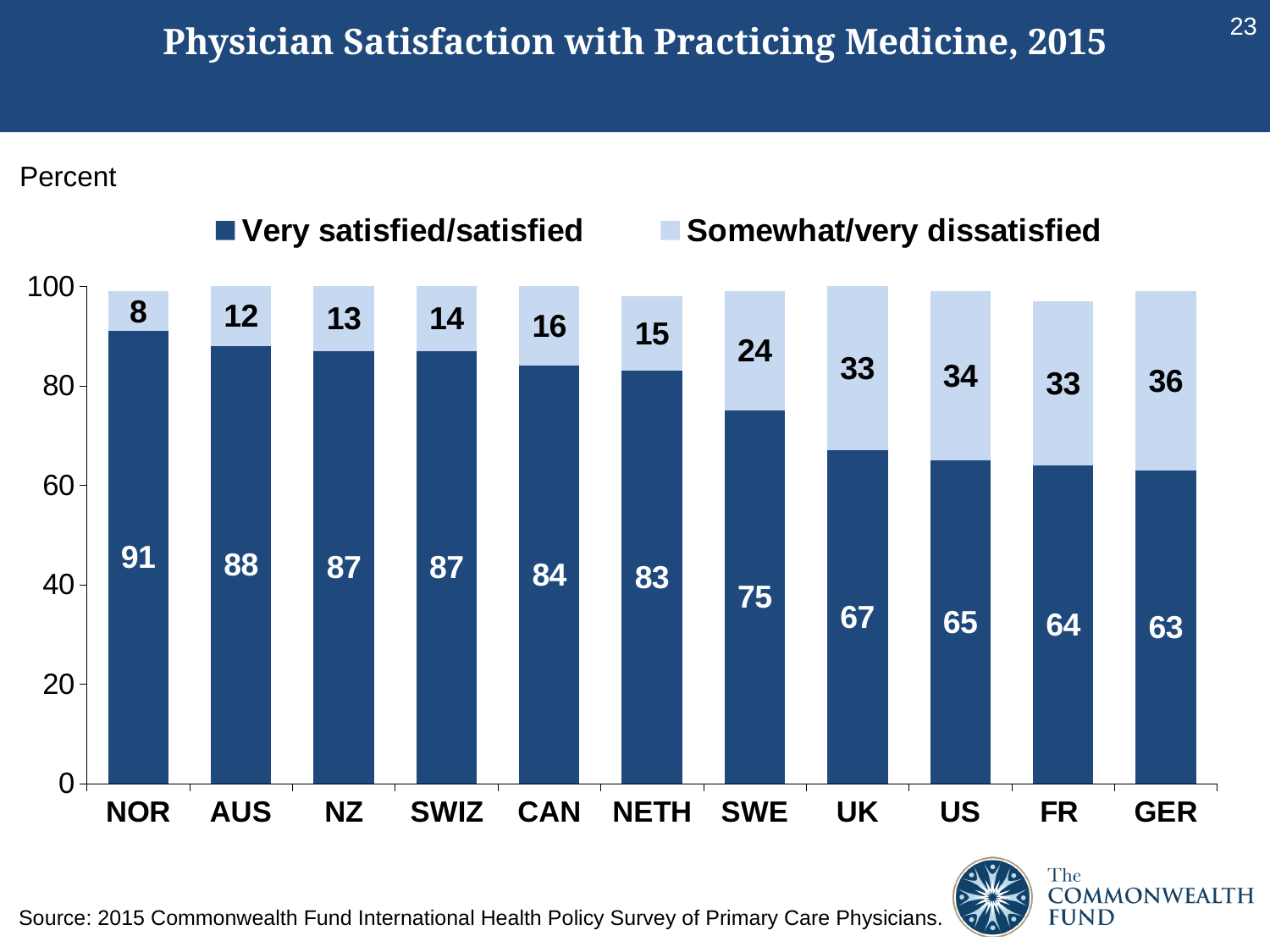
What kind of chart is shown on the slide? Stacked bar chart Which is larger, the Somewhat/very dissatisfied value for SWE or for UK? UK What is the Somewhat/very dissatisfied value for GER? 36 What is the total of the stacked bar for NETH? 98 Which country has the lowest Somewhat/very dissatisfied value? NOR Which country has the lowest Very satisfied/satisfied value? GER How many countries are shown on the x axis? 11 What percentage of physicians in NOR are very satisfied/satisfied? 91 How many series does the legend list? 2 What is the Very satisfied/satisfied value for SWE? 75 Which country has the highest Very satisfied/satisfied value? NOR What is the difference between the Very satisfied/satisfied values for NOR and GER? 28